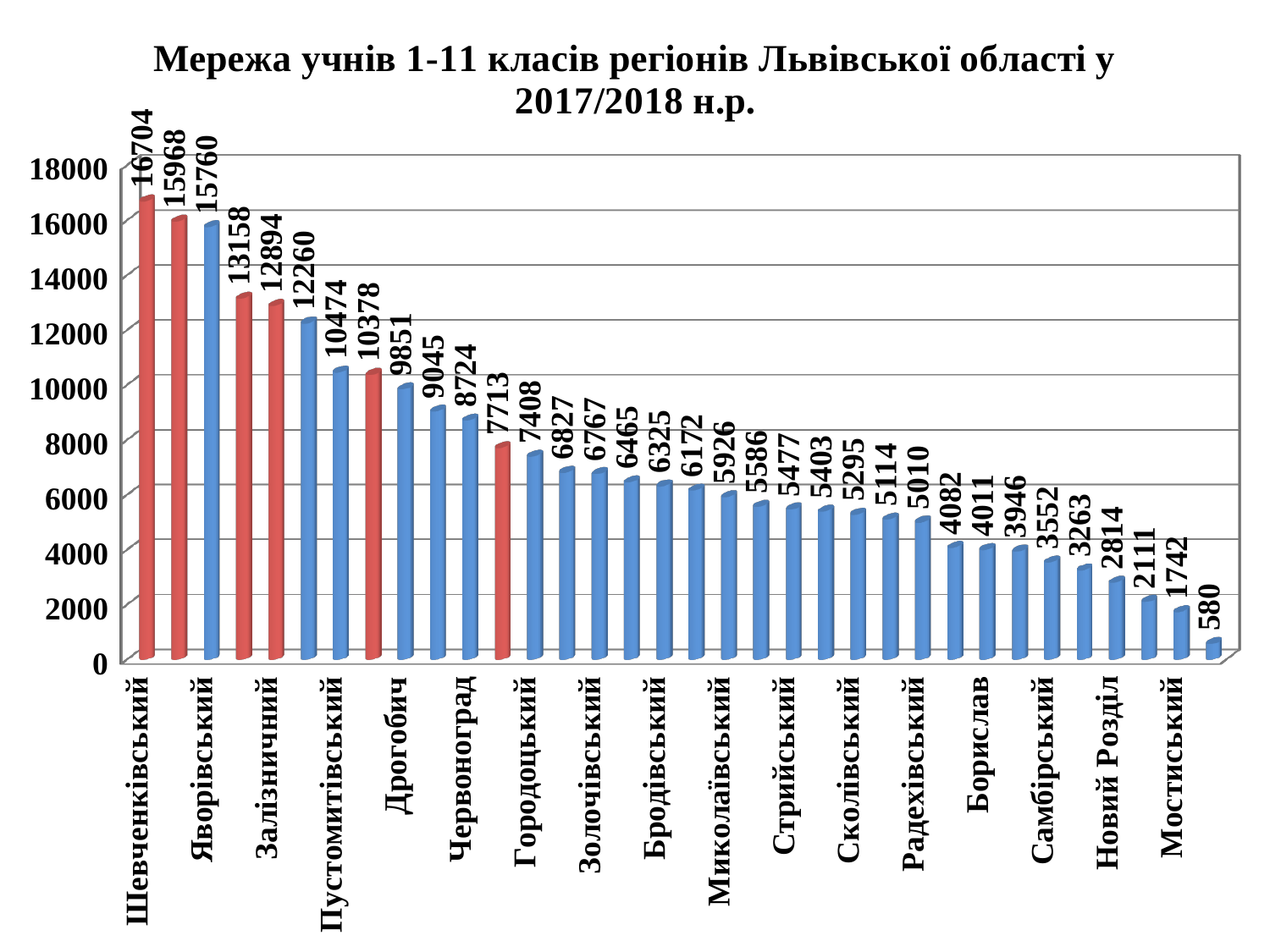
What kind of chart is shown on the slide? bar chart What is the value shown for Червоноград? 8724 What is the value shown for Дрогобич? 9851 What is the smallest value labelled on any bar in the chart? 580 What is the value shown for Шевченківський? 16704 What school year does the chart title refer to? 2017/2018 н.р. Do the bar values rise or fall from left to right along the x axis? fall Is the value for Пустомитівський greater or less than 10000? greater Which has a larger value, Городоцький or Золочівський? Городоцький What is the difference between the values for Шевченківський and Дрогобич? 6853 Which region has the highest number of pupils in the chart? Шевченківський What is the value shown for Борислав? 4011